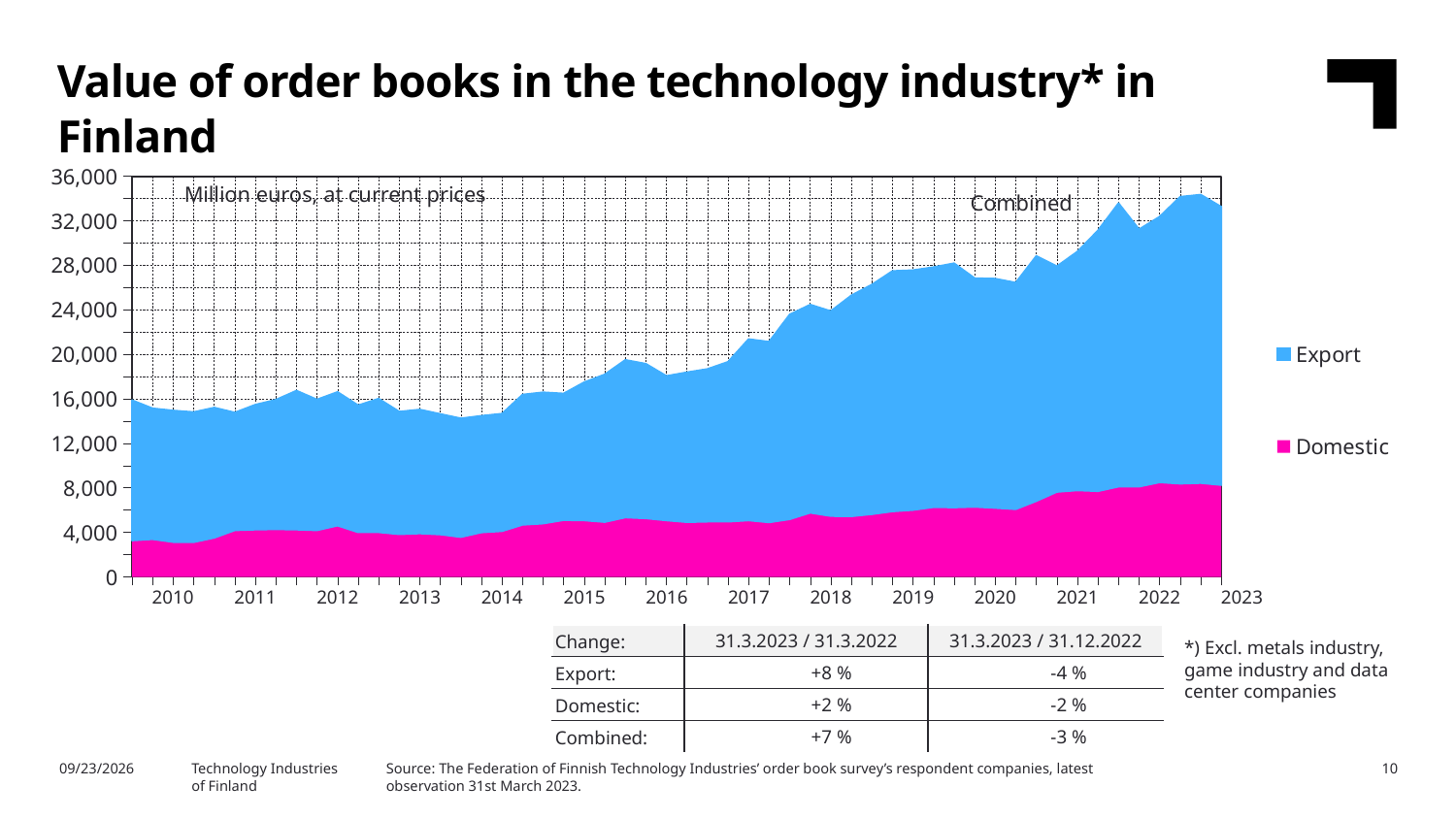
How many years are labelled on the x axis of the chart? 14 How many series does the chart legend list? 2 Is the Combined value at the start of 2010 greater or less than 12,000? greater What kind of chart is shown on the slide? Area chart Does the Domestic value generally rise or fall from 2010 to 2023? rise Is the Domestic value at the start of 2022 greater or less than 4,000? greater Is the Combined value at the start of 2016 greater or less than 20,000? less What are the two series named in the chart legend? Export and Domestic Which series is larger at the start of 2022, Export or Domestic? Export In what unit are the values on the chart expressed, according to the label inside the plot area? Million euros, at current prices